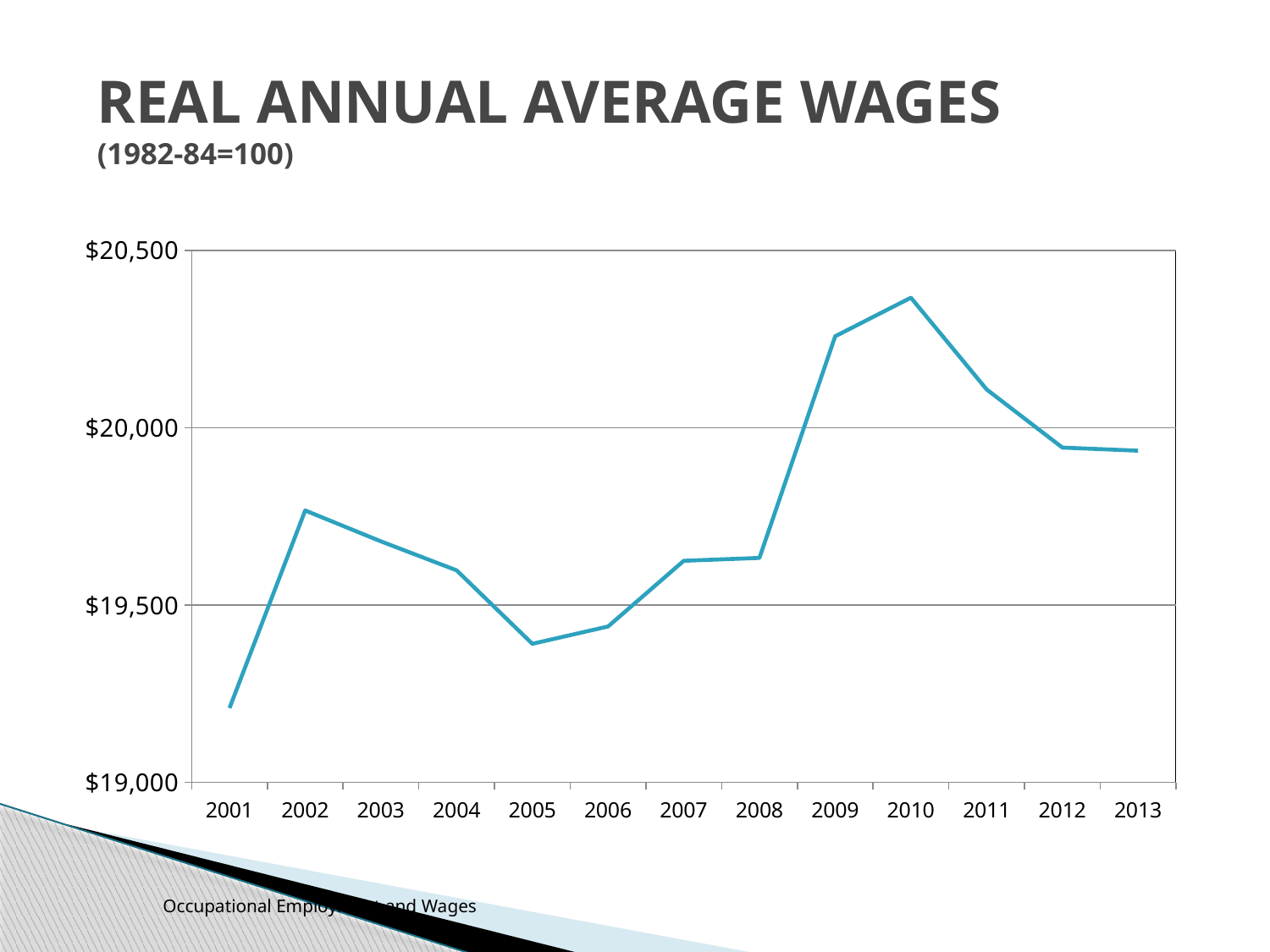
What kind of chart is shown on the slide? line chart In which year is the real annual average wage lowest? 2001 In which year is the real annual average wage highest? 2010 Is the value for 2002 greater or less than $19,500? greater What is the title of the chart on the slide? REAL ANNUAL AVERAGE WAGES Do the values rise or fall from 2010 to 2013? fall Which year has the larger real annual average wage, 2005 or 2009? 2009 Do the values rise or fall from 2008 to 2010? rise Is the value for 2009 greater or less than $20,000? greater Is the value for 2005 greater or less than $19,500? less How many years are plotted on the x axis of the chart? 13